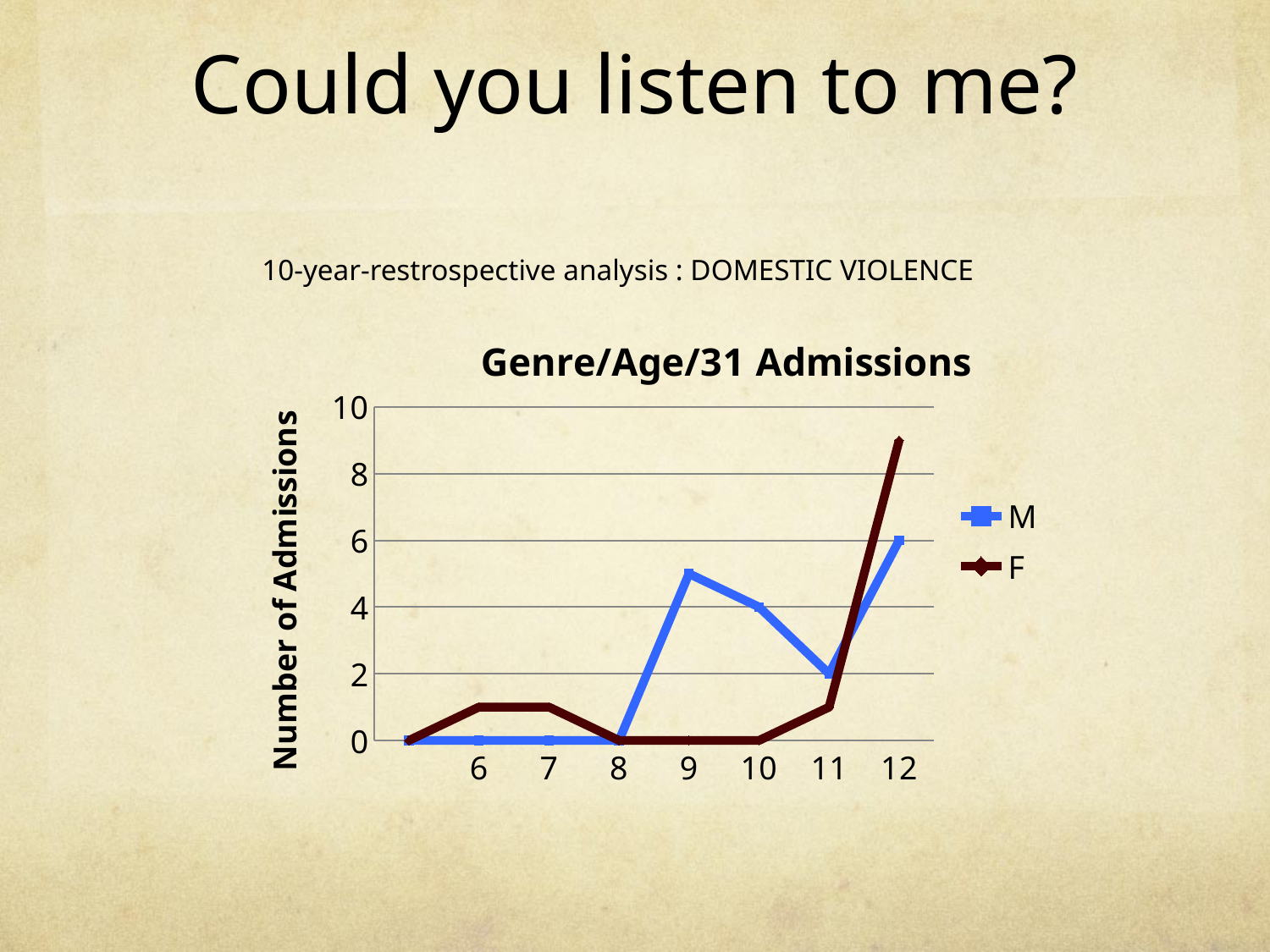
What is the value for series M at age 10? 4 What type of chart is shown on the slide? line chart What is the label of the vertical axis? Number of Admissions What is the value for series M at age 12? 6 Is the value for series M at age 9 greater or less than 4? greater What is the value for series M at age 11? 2 What is the value for series F at age 10? 0 Is the value for series F at age 12 greater or less than 8? greater At age 12, which series has the larger value, M or F? F How many series does the legend list? 2 What is the title of the chart? Genre/Age/31 Admissions At which age does series F reach its highest value? 12